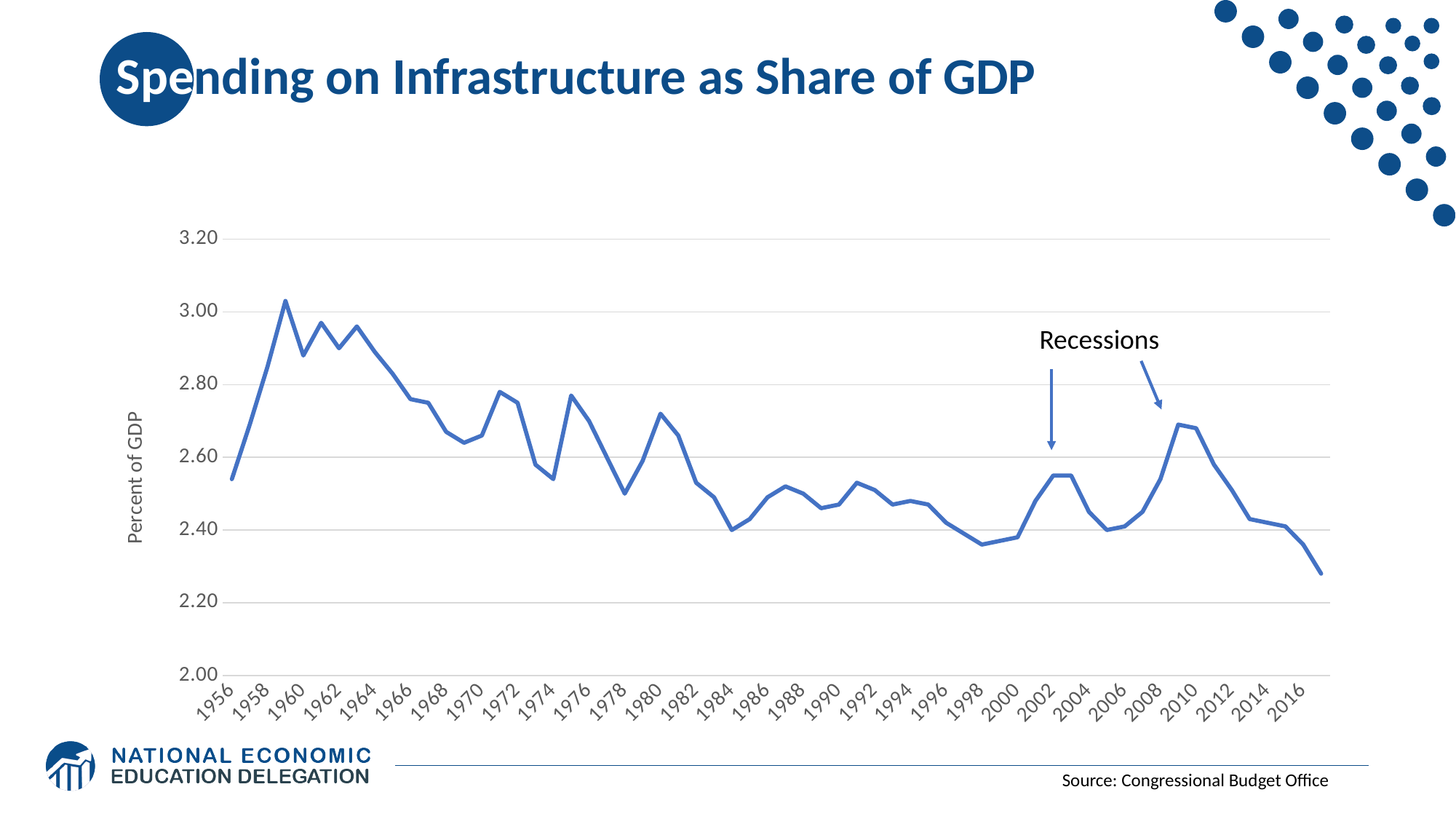
Overall, does infrastructure spending as a share of GDP rise or fall from 1956 to the end of the series? fall Is the value for 1960 greater or less than 2.80? greater Is the value for 1998 greater or less than 2.60? less Which year has the larger value, 1960 or 2010? 1960 Is the value for 2010 greater or less than 2.60? greater What is the label on the vertical axis of the chart? Percent of GDP Which year has the larger value, 1956 or 2016? 1956 What is the title of the chart? Spending on Infrastructure as Share of GDP What kind of chart is shown on the slide? line chart